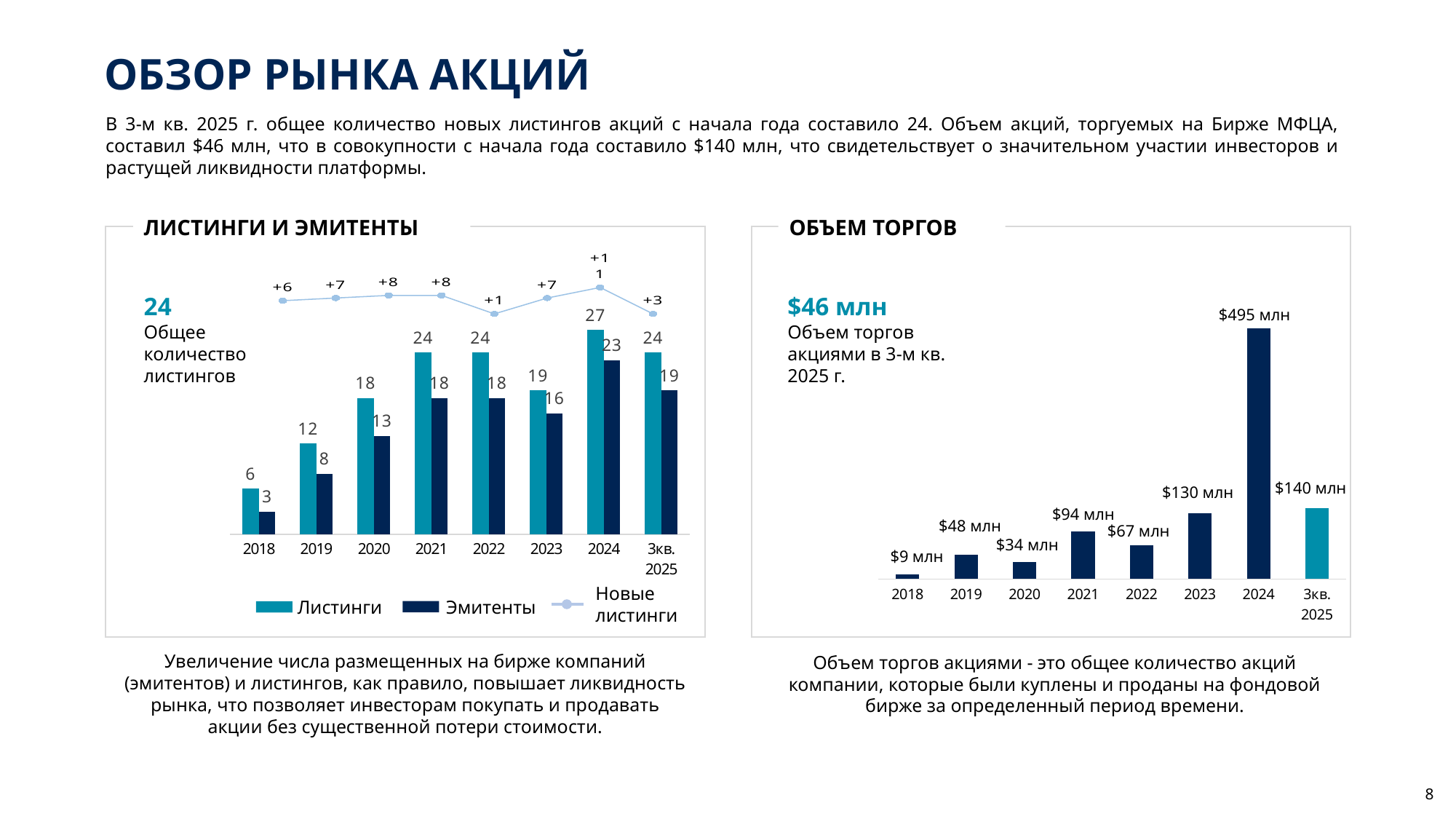
In the 'ЛИСТИНГИ И ЭМИТЕНТЫ' chart, what is the difference between Листинги and Эмитенты in 2019? 4 How many series does the legend of the 'ЛИСТИНГИ И ЭМИТЕНТЫ' chart list? 3 In the 'ОБЪЕМ ТОРГОВ' chart, what is the value for 2024? $495 млн In the 'ЛИСТИНГИ И ЭМИТЕНТЫ' chart, what is the value of Эмитенты for 2023? 16 In the 'ОБЪЕМ ТОРГОВ' chart, which year has the lowest trading volume? 2018 In the 'ОБЪЕМ ТОРГОВ' chart, what is the difference between the values for 2023 and 2022? $63 млн In the 'ЛИСТИНГИ И ЭМИТЕНТЫ' chart, what is the value of Листинги for 2020? 18 In the 'ЛИСТИНГИ И ЭМИТЕНТЫ' chart, which year has the highest value of Листинги? 2024 In the 'ЛИСТИНГИ И ЭМИТЕНТЫ' chart, what is the value of Новые листинги for 2022? +1 How many bars are shown in the 'ОБЪЕМ ТОРГОВ' chart? 8 In the 'ОБЪЕМ ТОРГОВ' chart, which is larger: the value for 2019 or the value for 2020? 2019 What kind of chart is the 'ОБЪЕМ ТОРГОВ' chart? Bar chart